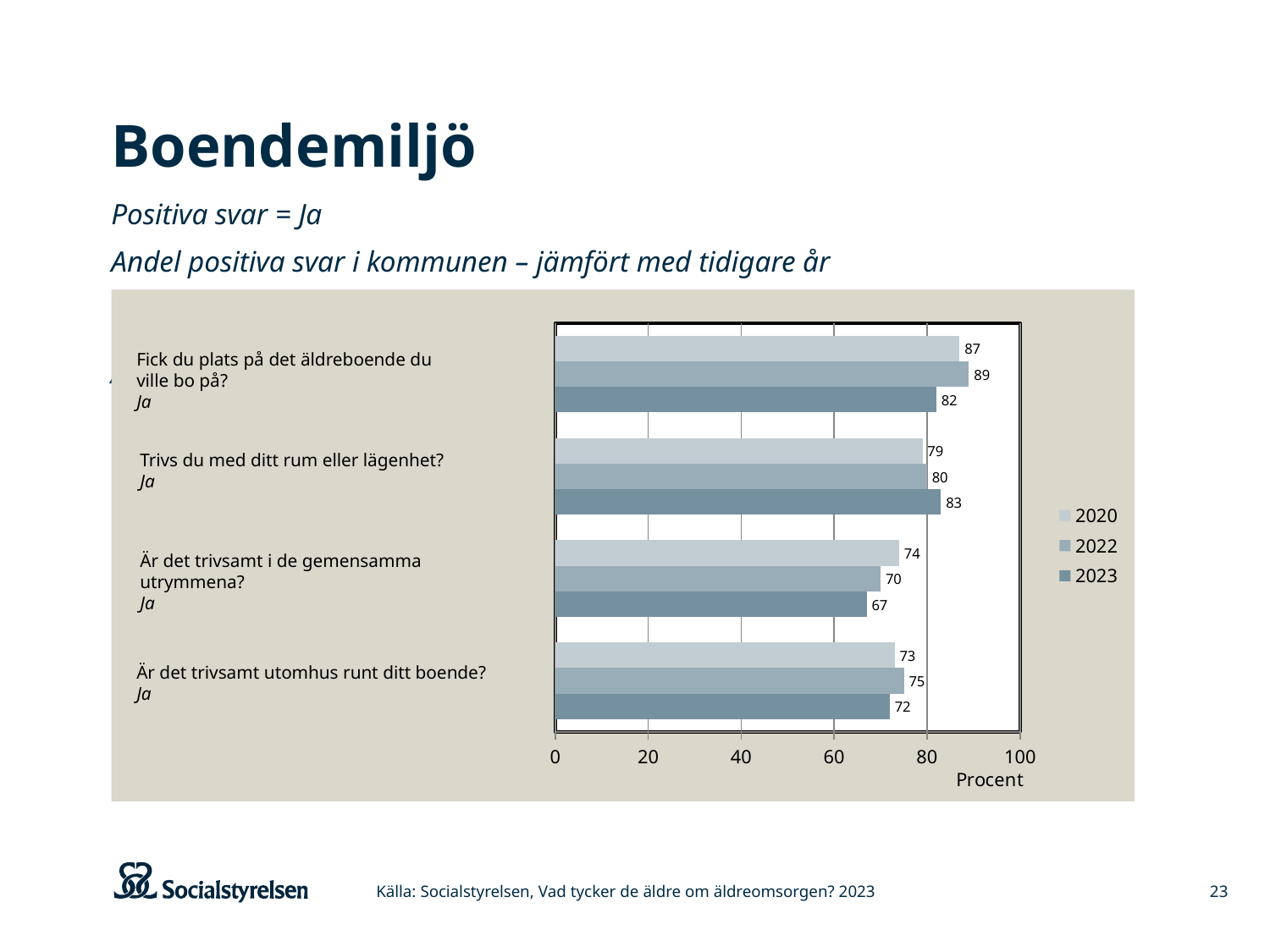
Which category has the highest 2022 value? Fick du plats på det äldreboende du ville bo på? How many series does the legend list? 3 What is the 2023 value for "Fick du plats på det äldreboende du ville bo på?"? 82 For "Är det trivsamt utomhus runt ditt boende?", which year has the larger value, 2020 or 2022? 2022 What kind of chart is shown on the slide? Bar chart Which category has the lowest 2023 value? Är det trivsamt i de gemensamma utrymmena? Is the 2023 value for "Trivs du med ditt rum eller lägenhet?" greater or less than 80? greater What is the 2020 value for "Är det trivsamt i de gemensamma utrymmena?"? 74 What label is shown on the horizontal axis of the chart? Procent How many question categories are plotted in the chart? 4 What is the difference between the 2022 and 2023 values for "Fick du plats på det äldreboende du ville bo på?"? 7 What is the 2022 value for "Trivs du med ditt rum eller lägenhet?"? 80